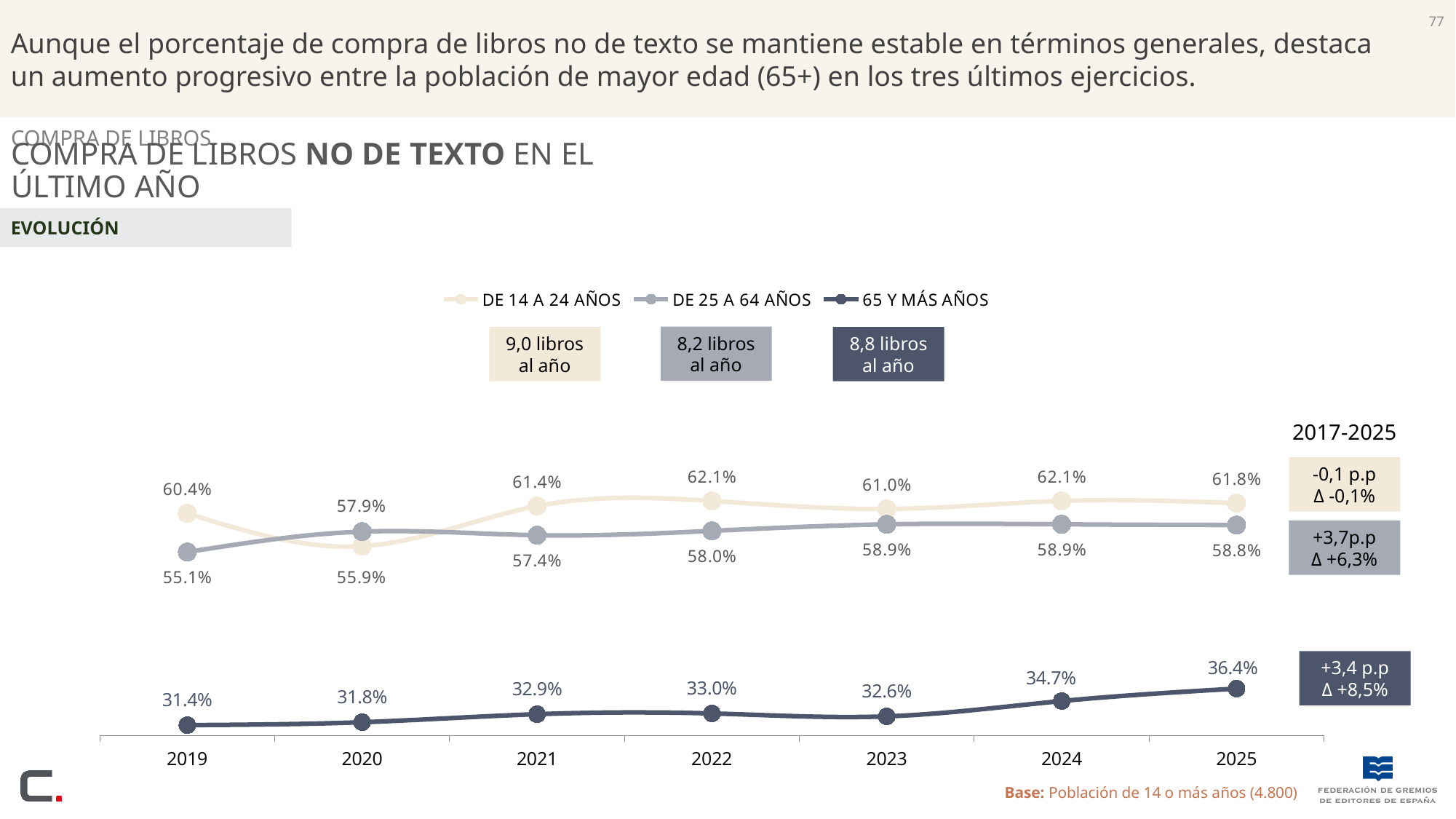
How many series does the legend list? 3 What is the value for DE 14 A 24 AÑOS in 2019? 60.4% Does the value for 65 Y MÁS AÑOS rise or fall from 2023 to 2025? Rise In which year is the value for 65 Y MÁS AÑOS highest? 2025 What is the difference between the 2025 and 2019 values for 65 Y MÁS AÑOS? 5.0 percentage points What is the value for 65 Y MÁS AÑOS in 2025? 36.4% In which year is the value for DE 25 A 64 AÑOS lowest? 2019 What is the value for DE 25 A 64 AÑOS in 2021? 57.4% Which is larger in 2020: the value for DE 14 A 24 AÑOS or DE 25 A 64 AÑOS? DE 25 A 64 AÑOS How many books per year are shown in the box for the DE 25 A 64 AÑOS group? 8,2 libros al año How many years are shown on the x axis? 7 What kind of chart is shown on the slide? Line chart